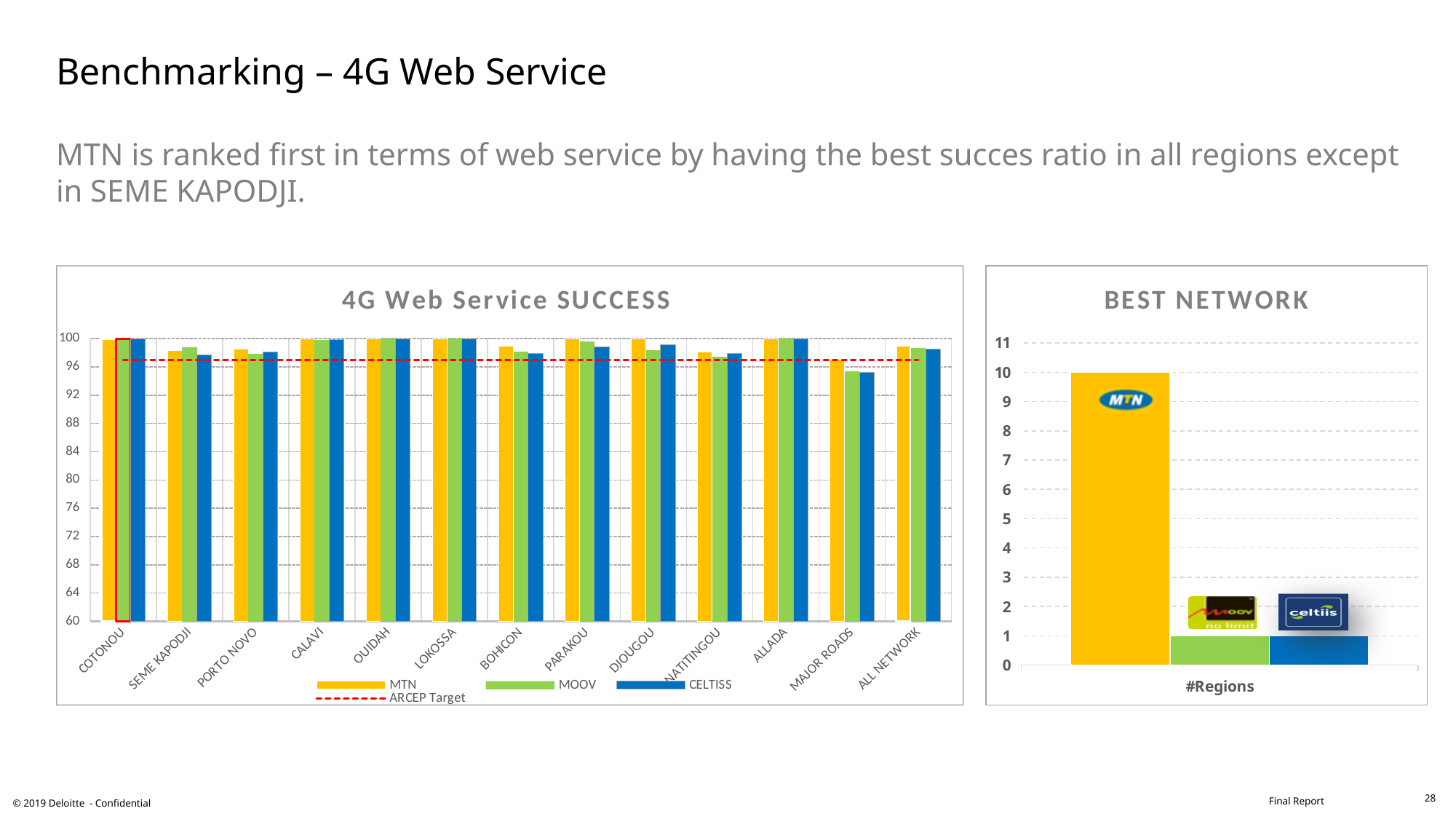
In the 'BEST NETWORK' chart, what is the value for MOOV? 1 What is the x-axis label of the 'BEST NETWORK' chart? #Regions In the '4G Web Service SUCCESS' chart, is the MTN value for CALAVI greater or less than 96? greater In the '4G Web Service SUCCESS' chart, which is larger for MAJOR ROADS: the MTN value or the CELTISS value? MTN What kind of chart is the '4G Web Service SUCCESS' chart? combination bar and line chart What kind of chart is the 'BEST NETWORK' chart? bar chart In the 'BEST NETWORK' chart, what is the value for MTN? 10 In the 'BEST NETWORK' chart, which network has the highest value? MTN How many categories are shown on the x axis of the '4G Web Service SUCCESS' chart? 13 How many entries does the legend of the '4G Web Service SUCCESS' chart list? 4 In the '4G Web Service SUCCESS' chart, is the MOOV value for MAJOR ROADS greater or less than 96? less In the 'BEST NETWORK' chart, what is the difference between the MTN value and the CELTISS value? 9